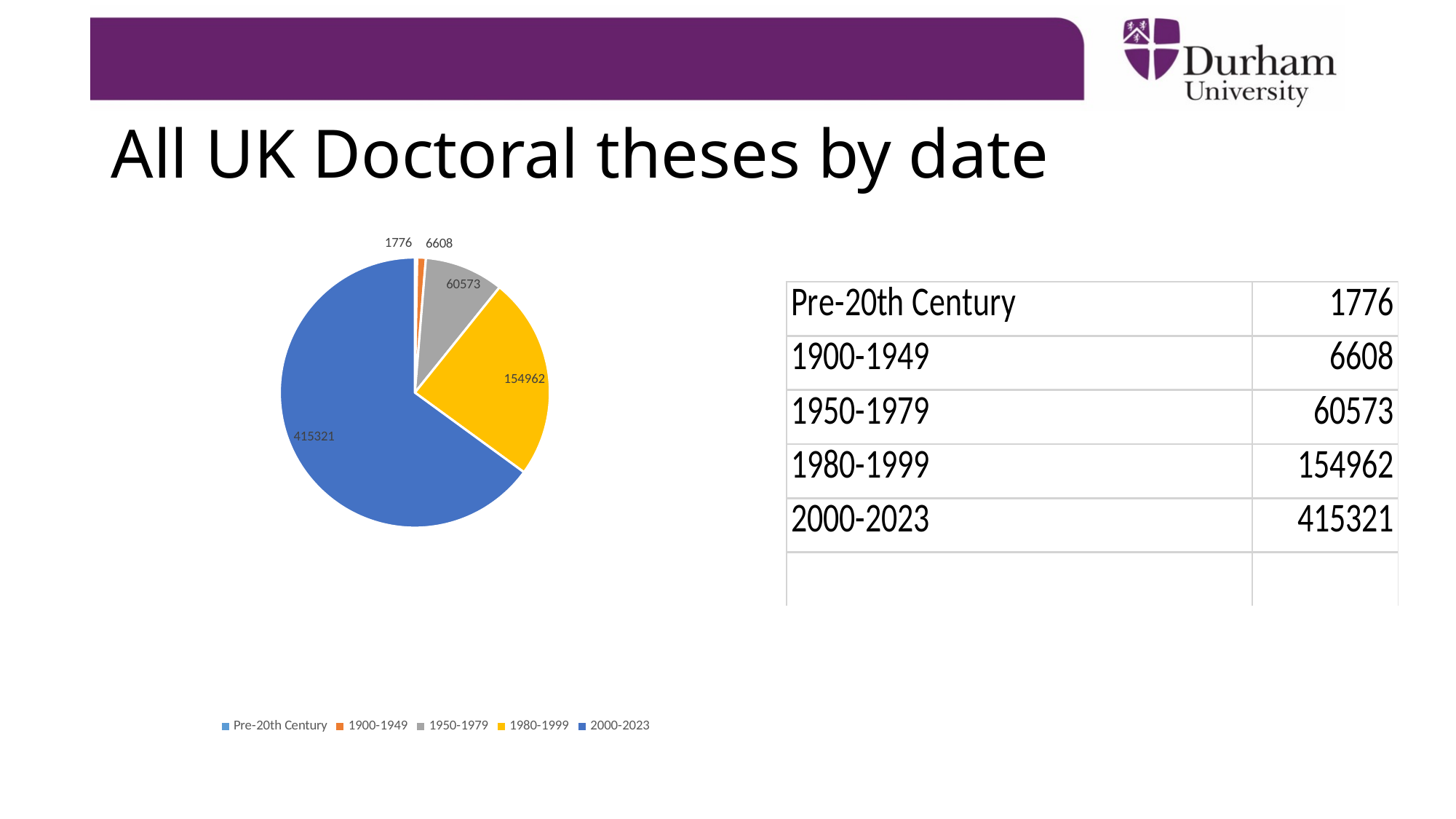
Which is larger in the pie chart, 1950-1979 or 1900-1949? 1950-1979 What is the title of the slide containing the pie chart? All UK Doctoral theses by date What is the difference between the values for 1900-1949 and Pre-20th Century? 4832 How many slices does the pie chart have? 5 What is the difference between the values for 2000-2023 and 1980-1999? 260359 What is the value for 1950-1979 in the pie chart? 60573 What is the value for 2000-2023 in the pie chart? 415321 How many entries does the legend of the pie chart list? 5 Which category has the largest slice in the pie chart? 2000-2023 What kind of chart is shown on the slide? pie chart What is the value for Pre-20th Century in the pie chart? 1776 Which category has the smallest slice in the pie chart? Pre-20th Century